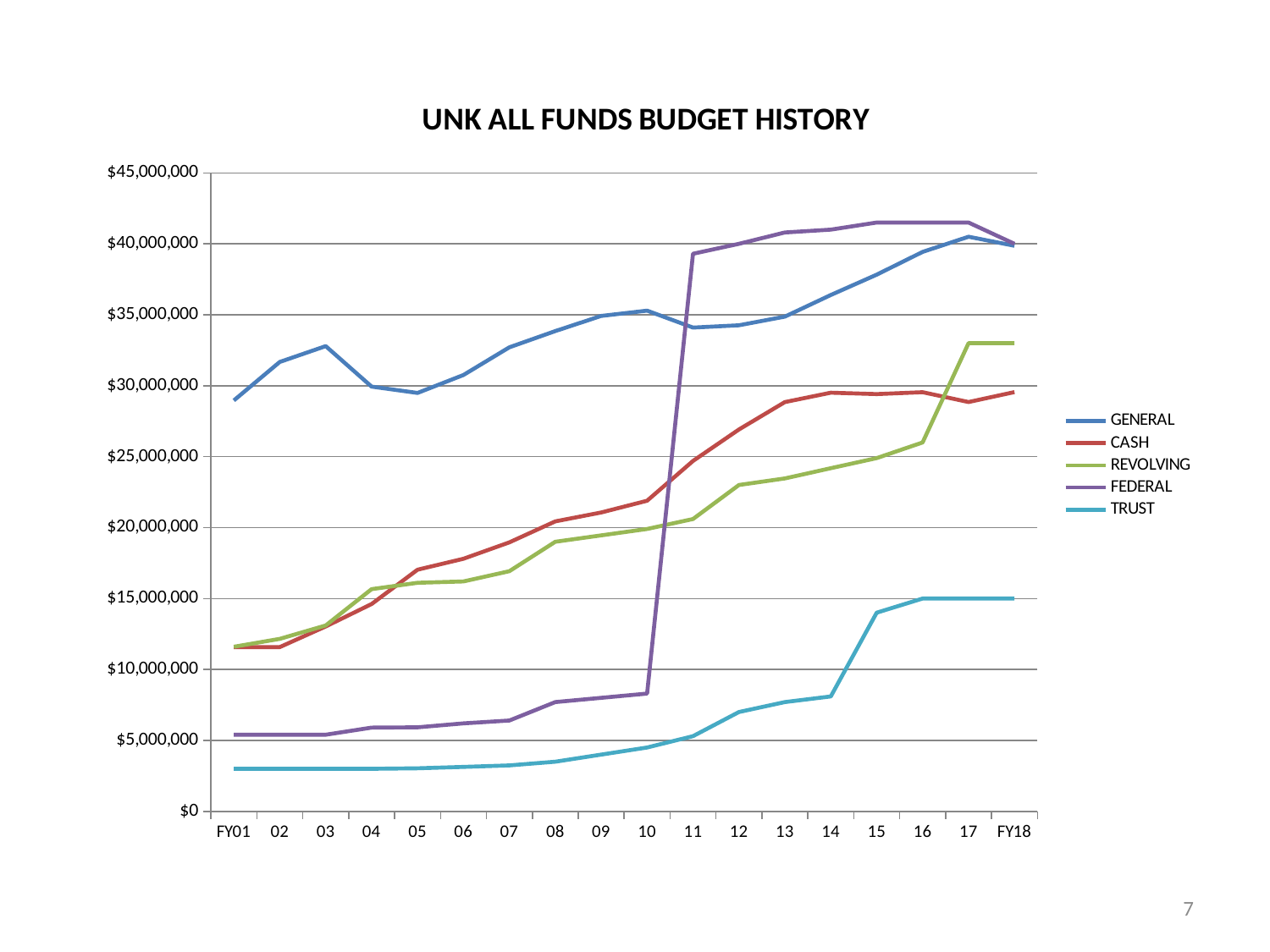
Is the FEDERAL value in FY11 greater or less than $35,000,000? greater How many fiscal years are plotted along the x axis? 18 What is the title of the chart? UNK ALL FUNDS BUDGET HISTORY In FY15, which series has the higher value, GENERAL or FEDERAL? FEDERAL How many series does the legend list? 5 Is the TRUST value in FY18 greater or less than $10,000,000? greater Which series has the lowest value in FY01? TRUST Is the GENERAL value in FY01 greater or less than $25,000,000? greater Does the TRUST series rise or fall from FY01 to FY18? rise What kind of chart is shown on the slide? line chart In FY13, which series has the higher value, CASH or REVOLVING? CASH